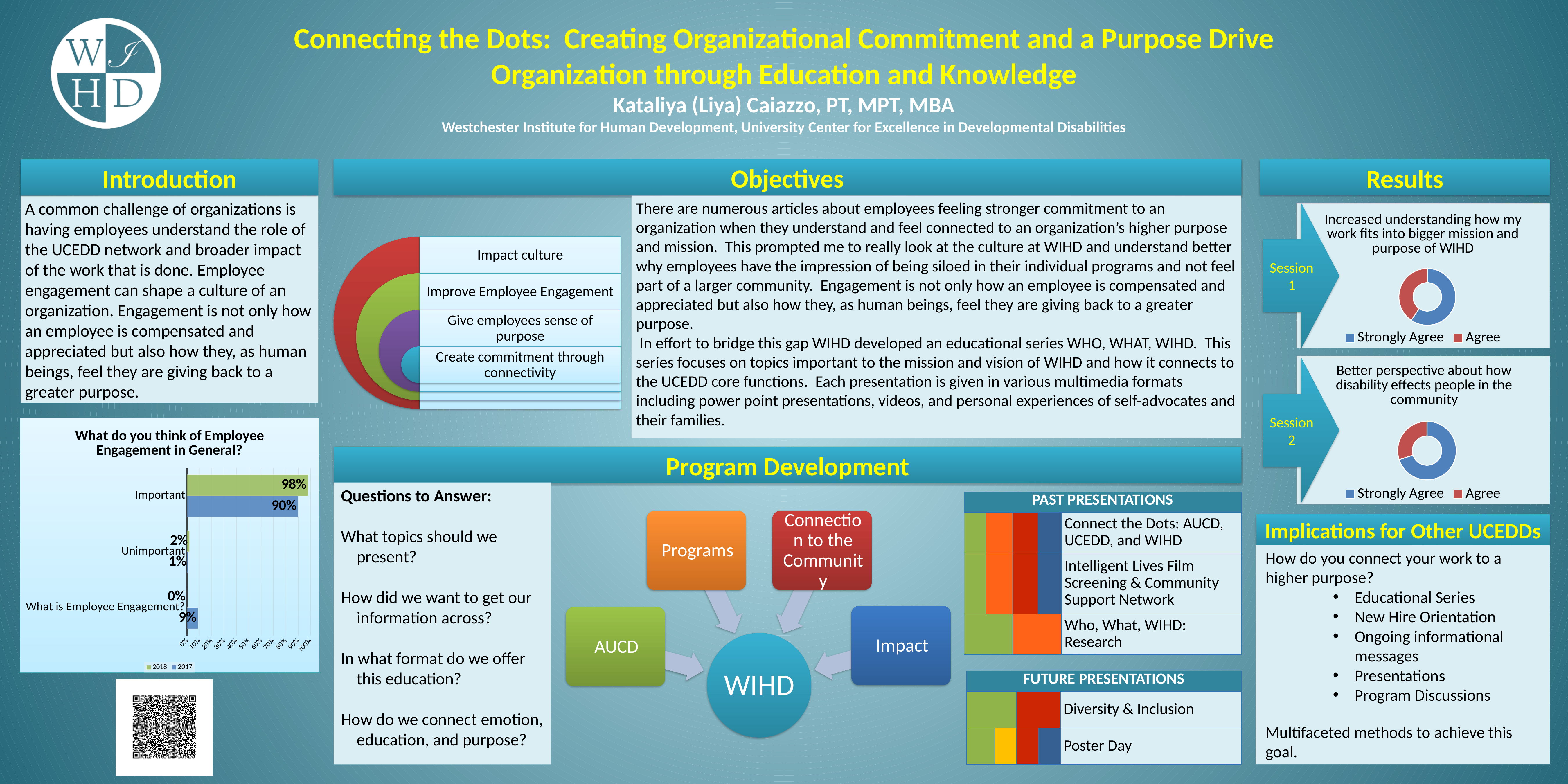
In the chart 'What do you think of Employee Engagement in General?', what is the 2017 value for 'What is Employee Engagement?' 9% In the chart 'What do you think of Employee Engagement in General?', what is the 2018 value for Unimportant? 2% In the chart 'What do you think of Employee Engagement in General?', what is the 2018 value for Important? 98% How many categories are shown in the chart 'What do you think of Employee Engagement in General?' 3 How many series does the legend of the chart 'What do you think of Employee Engagement in General?' list? 2 In the Session 1 donut chart under Results, which response has the larger share: Strongly Agree or Agree? Strongly Agree In the chart 'What do you think of Employee Engagement in General?', what is the 2017 value for Important? 90% What kind of chart is 'What do you think of Employee Engagement in General?' Bar chart In the chart 'What do you think of Employee Engagement in General?', which category has the lowest value for 2018? What is Employee Engagement? In the chart 'What do you think of Employee Engagement in General?', which category has the highest value for 2018? Important In the chart 'What do you think of Employee Engagement in General?', which is larger for 'What is Employee Engagement?': the 2018 value or the 2017 value? 2017 In the chart 'What do you think of Employee Engagement in General?', what is the difference between the 2018 and 2017 values for Important? 8%